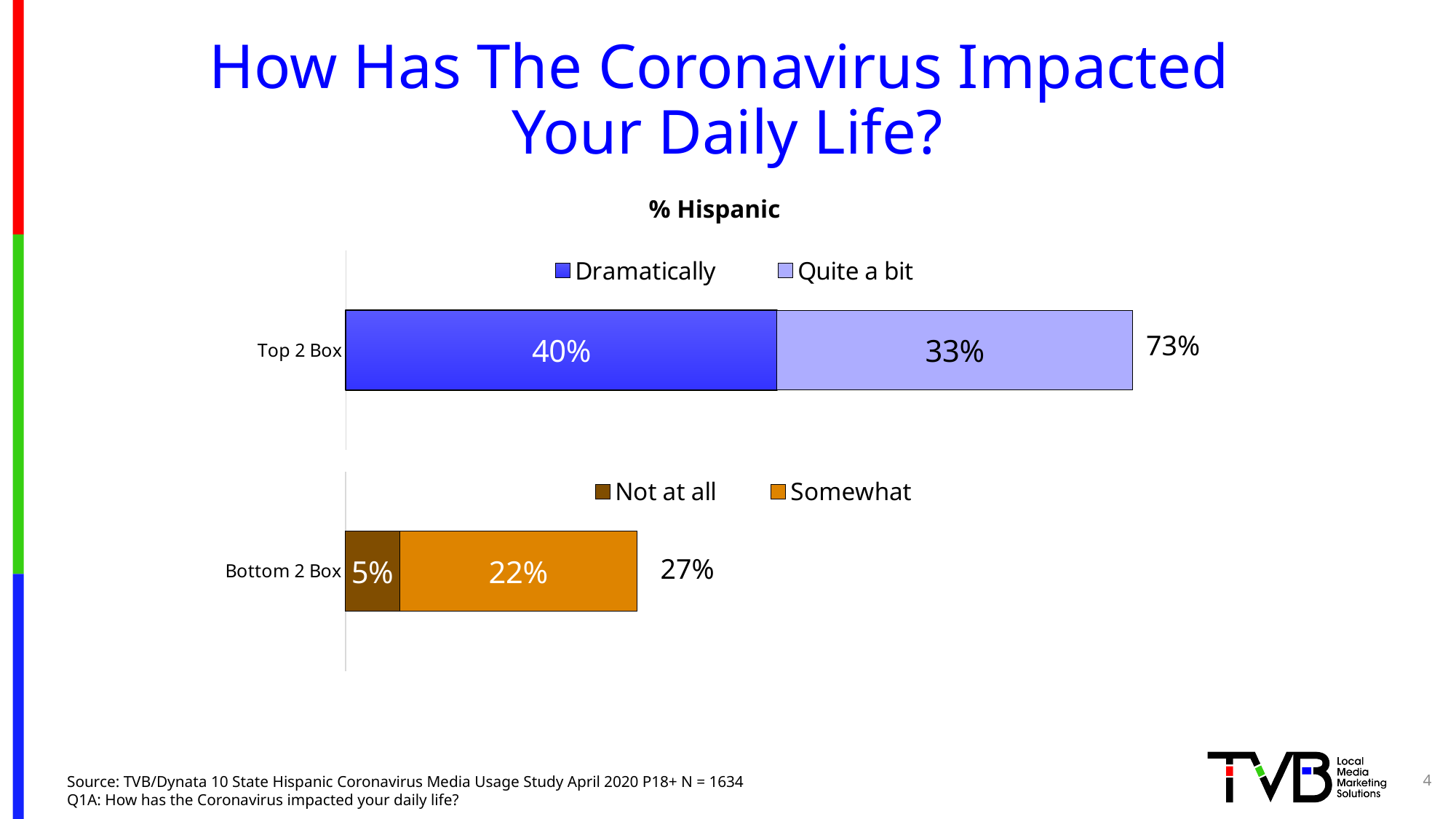
Which segment across both bars has the smallest value? Not at all In the Bottom 2 Box bar, what percentage is shown for Somewhat? 22% In the Bottom 2 Box bar, what percentage is shown for Not at all? 5% Which is larger, the Dramatically value in the Top 2 Box bar or the Somewhat value in the Bottom 2 Box bar? Dramatically What kind of chart is shown on the slide? Stacked bar chart In the Top 2 Box bar, what percentage is shown for Quite a bit? 33% In the Top 2 Box bar, what is the difference between the Dramatically and Quite a bit values? 7 percentage points What is the total shown for the Bottom 2 Box bar? 27% What is the total shown for the Top 2 Box bar? 73% In the Top 2 Box bar, what percentage is shown for Dramatically? 40% What is the title shown above the chart? % Hispanic In the Bottom 2 Box bar, what is the difference between the Somewhat and Not at all values? 17 percentage points